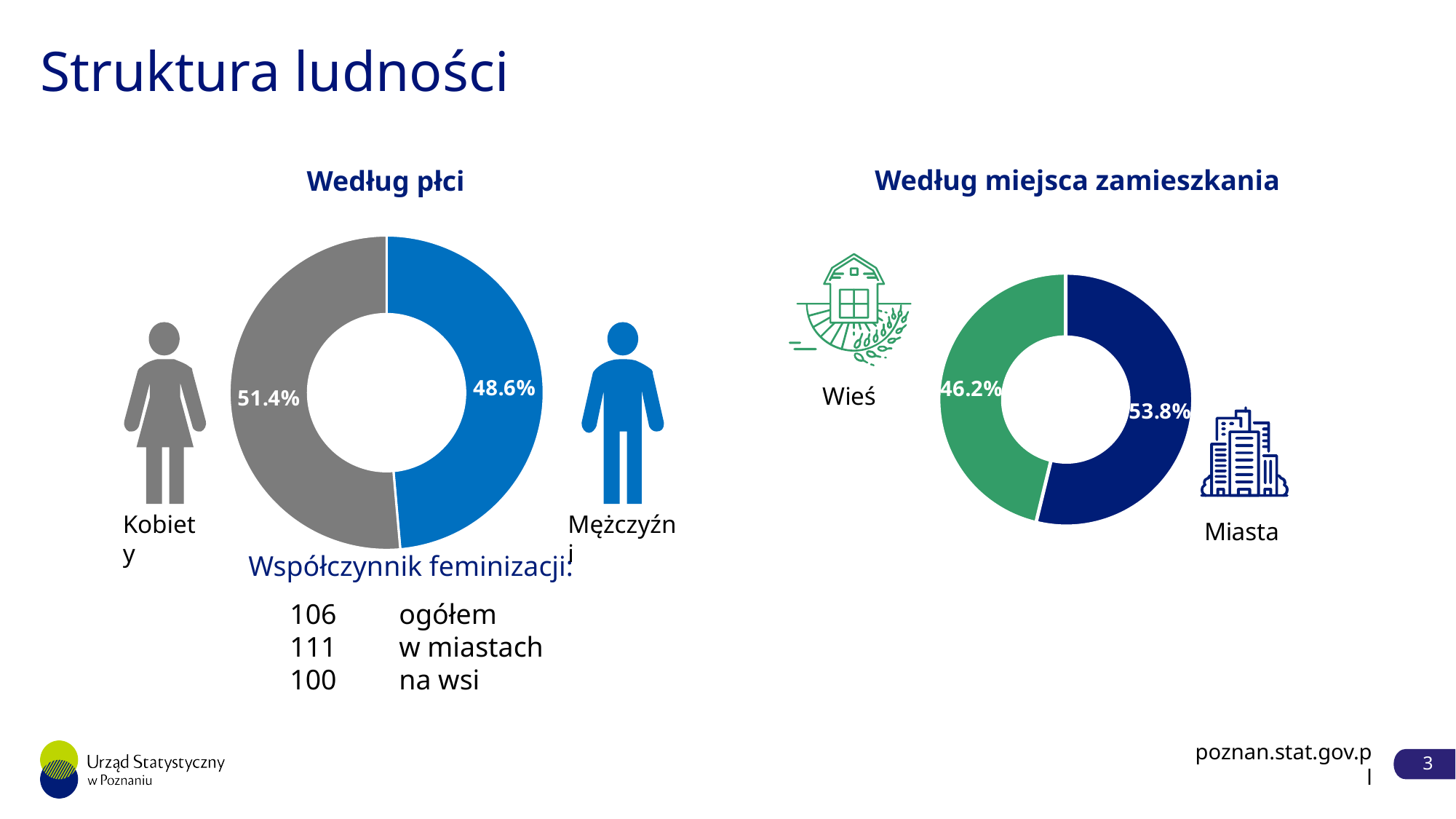
In the 'Według miejsca zamieszkania' chart, which category has the smaller share? Wieś In the 'Według płci' chart, what is the difference in percentage points between Kobiety and Mężczyźni? 2.8 In the 'Według miejsca zamieszkania' chart, what share is shown for Wieś? 46.2% In the 'Według płci' chart, which group has the larger share? Kobiety How many categories does the 'Według płci' chart show? 2 In the 'Według miejsca zamieszkania' chart, what colour is the Wieś segment? green In the 'Według płci' chart, what share is shown for Mężczyźni? 48.6% In the 'Według płci' chart, what share is shown for Kobiety? 51.4% What kind of chart is used for 'Według miejsca zamieszkania'? doughnut chart Which is larger: the share for Miasta in the right chart or the share for Kobiety in the left chart? Miasta In the 'Według miejsca zamieszkania' chart, what is the difference in percentage points between Miasta and Wieś? 7.6 In the 'Według miejsca zamieszkania' chart, what share is shown for Miasta? 53.8%